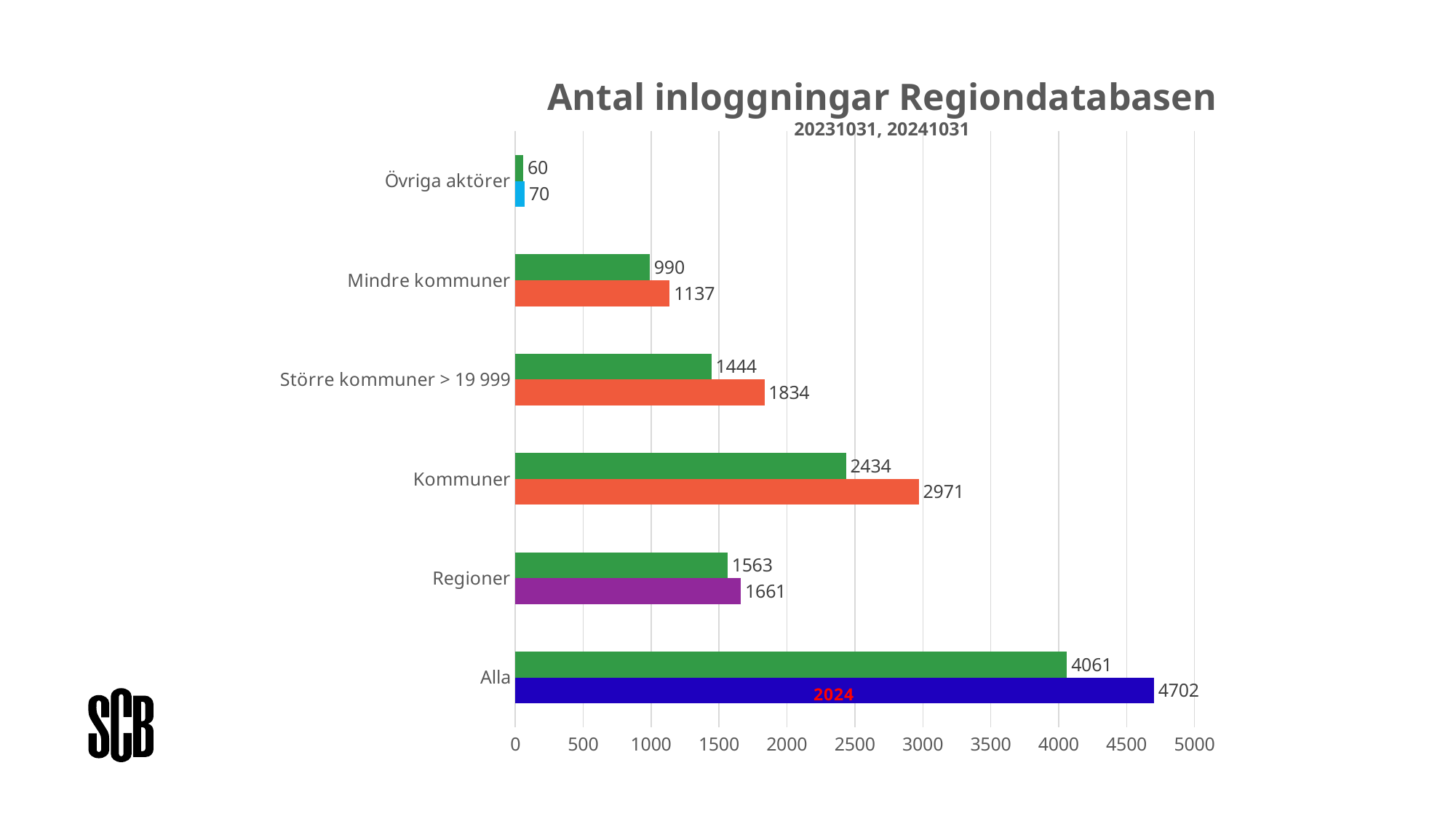
What is the difference between the two bars for Mindre kommuner (1137 and 990)? 147 What is the value of the green bar for Kommuner? 2434 Which category has the lowest number of logins? Övriga aktörer How many categories are shown on the y axis? 6 Which green bar is larger: Regioner or Större kommuner > 19 999? Regioner Which category has the highest number of logins? Alla What is the difference between the two bars for Kommuner (2971 and 2434)? 537 What is the value of the purple bar for Regioner? 1661 What is the value of the lower bar (labelled 2024) for Alla? 4702 What type of chart is shown on the slide? Bar chart What is the difference between the two bars for Alla (4702 and 4061)? 641 What is the value of the blue bar for Övriga aktörer? 70